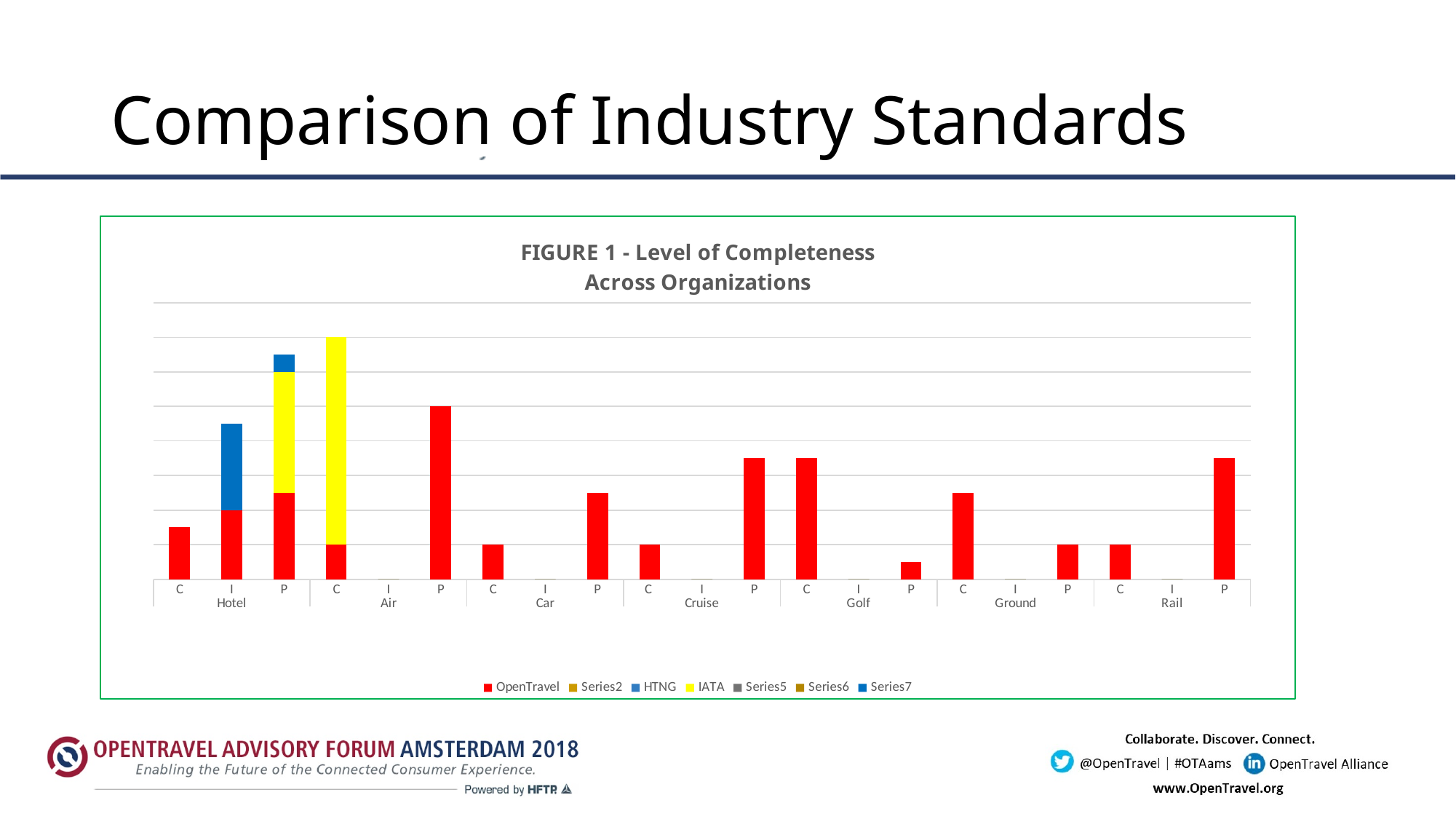
How many individual bar positions (C, I, P across all industries) are there on the x axis? 21 Which bar position has the tallest OpenTravel (red) bar? Air P Which series is shown in yellow in the chart? IATA Which bar position has the tallest stacked bar overall? Air C How many industry groups are shown along the x axis of the chart? 7 In which industry groups does the IATA series appear? Hotel and Air Within the Golf group, which is larger for OpenTravel: C or P? C Within the Hotel group, which is larger for OpenTravel: C or I? I What kind of chart is shown on the slide? Stacked bar chart Which is larger for OpenTravel: Car P or Rail P? Rail P What is the title of the chart? FIGURE 1 - Level of Completeness Across Organizations How many series does the chart legend list? 7